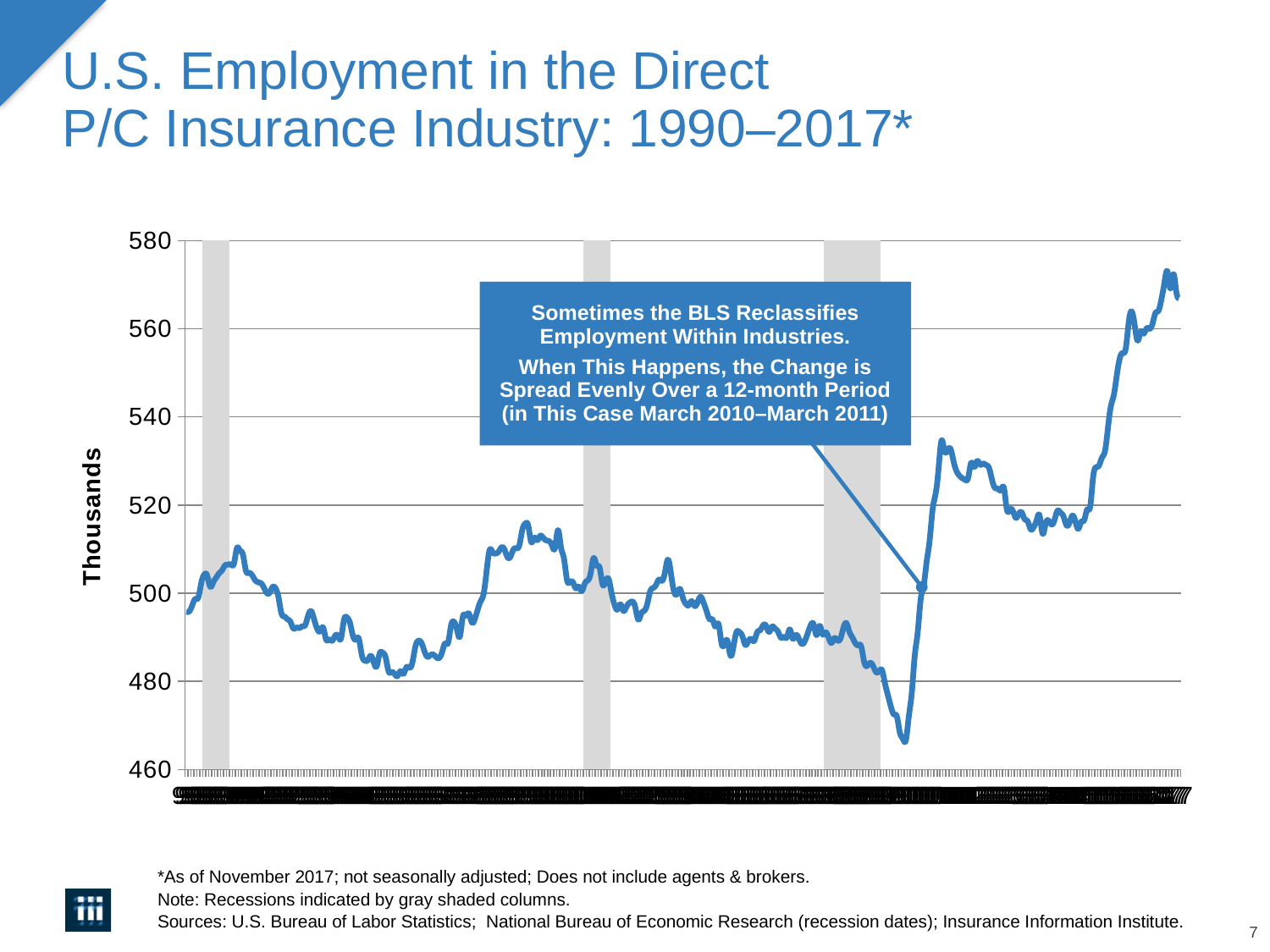
Which is larger: the value at the right end of the line or the value at the left end of the line? the right end What is the highest value shown on the vertical axis? 580 Is the highest point of the line greater or less than 560? greater Is the lowest point of the line greater or less than 480? less What is the title of the chart on the slide? U.S. Employment in the Direct P/C Insurance Industry: 1990–2017* How many gray shaded recession columns appear on the chart? 3 How many lines are plotted on the chart? 1 Is the value at the right end of the line (November 2017) greater or less than 540? greater What kind of chart is shown on the slide? line chart What is the label on the vertical axis of the chart? Thousands Does the line end higher or lower than it starts? higher